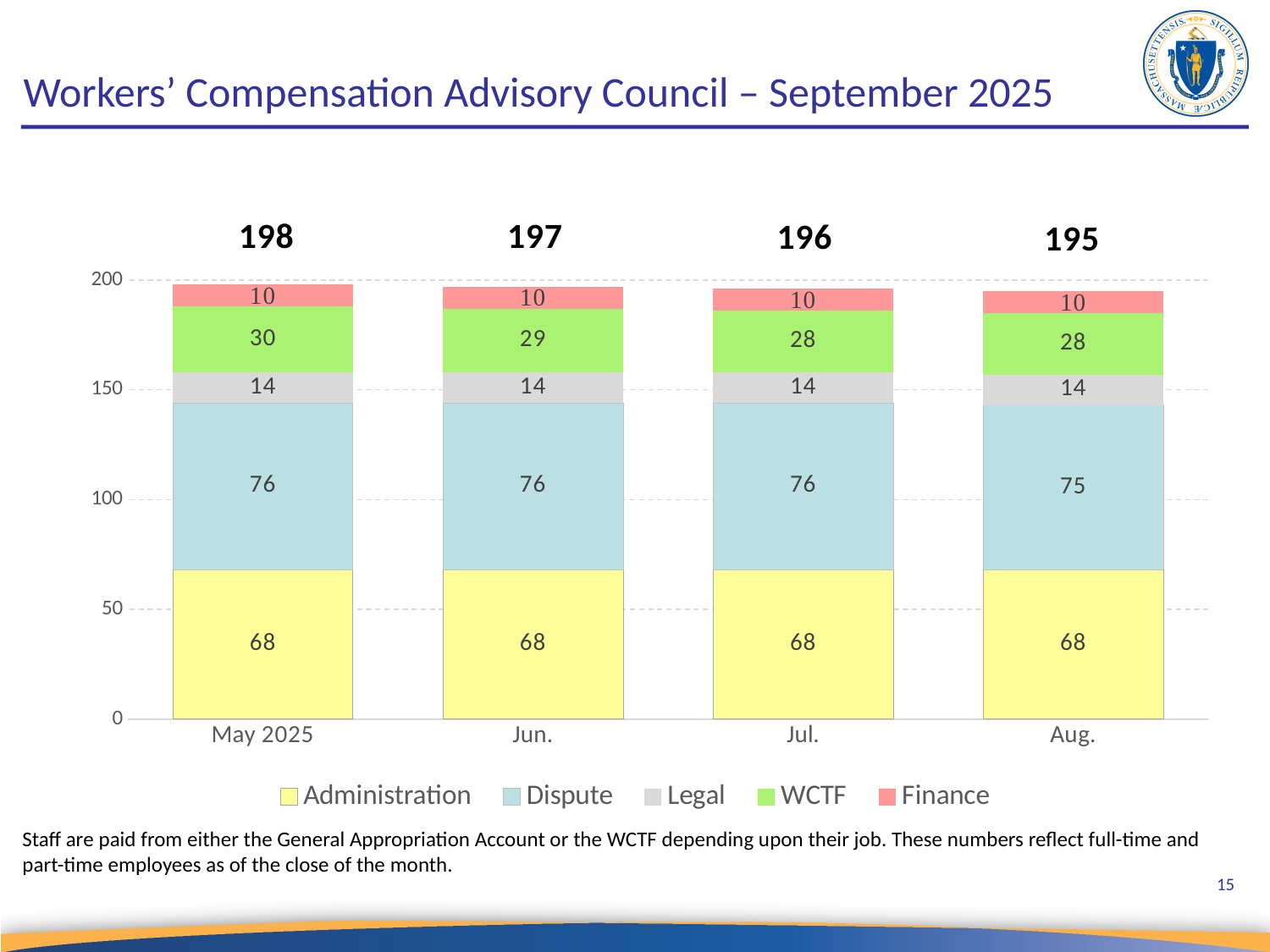
Which month has the lowest total staff count? Aug. How many months are shown on the x axis? 4 What is the total of the stacked bar for Aug.? 195 What is the WCTF value for May 2025? 30 Which month has the highest total staff count? May 2025 Do the total staff counts rise or fall from May 2025 to Aug.? fall What is the difference between the WCTF value for May 2025 and the WCTF value for Jul.? 2 What is the total of the stacked bar for Jun.? 197 What is the Finance value for Jul.? 10 Which is larger, the Administration value for Jun. or the Dispute value for Jun.? Dispute What is the Dispute value for Aug.? 75 How many series does the legend list? 5